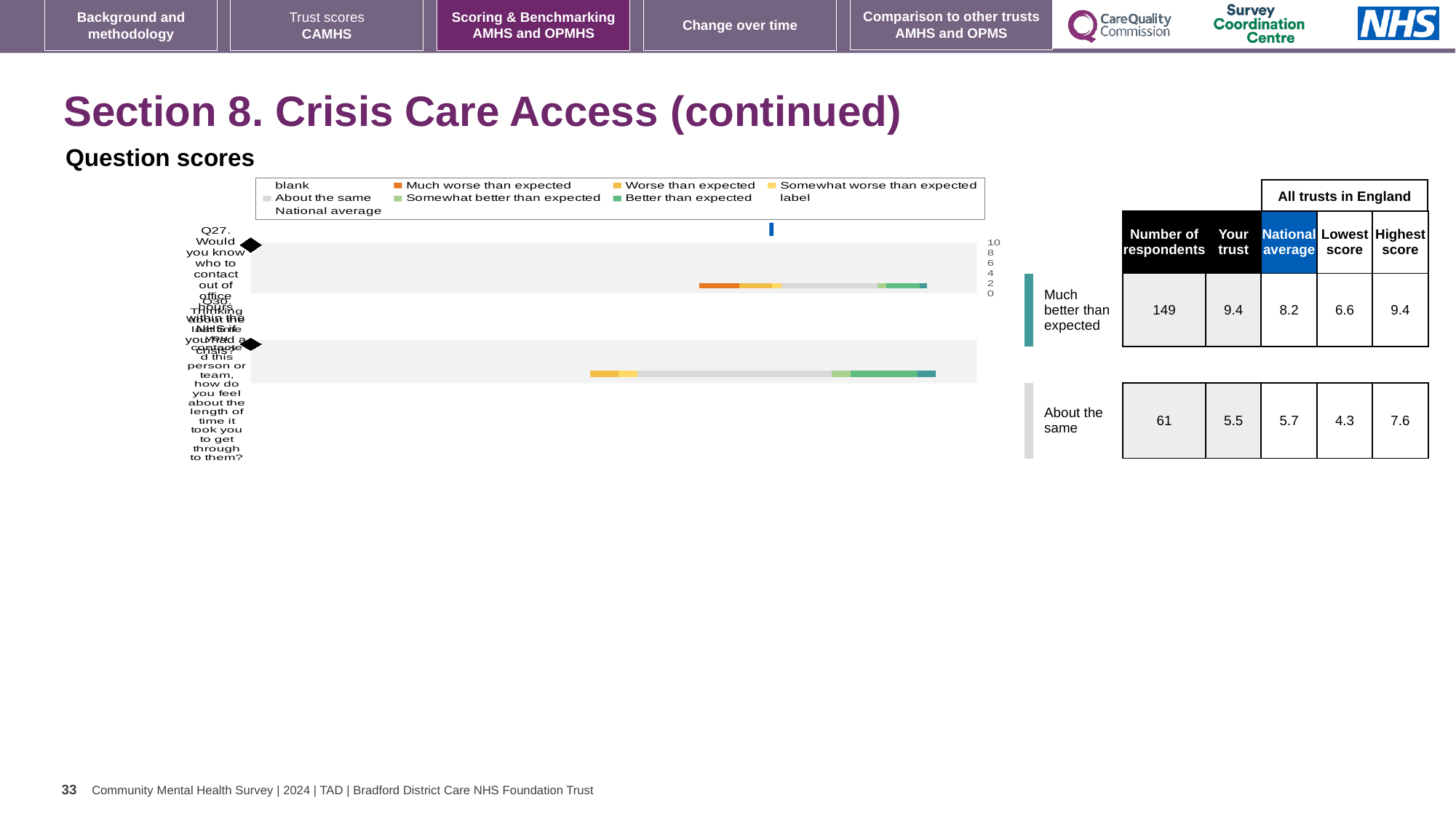
What type of chart is used to show the question scores? bar chart How many respondents answered Q30? 61 What is the national average score for Q27? 8.2 What is the difference between the highest score and the lowest score for Q30? 3.3 What is the maximum value shown on the score axis of the chart? 10 What is the 'Your trust' score for Q27 (would you know who to contact out of office hours)? 9.4 How many questions are plotted in the question scores chart? 2 For Q27, which is higher: the trust's score or the national average? Your trust How is the trust's result for Q27 categorised relative to expectation? Much better than expected What is the difference between the highest score and the lowest score for Q27? 2.8 What is the 'Your trust' score for Q30? 5.5 For Q30, which is higher: the trust's score or the national average? National average